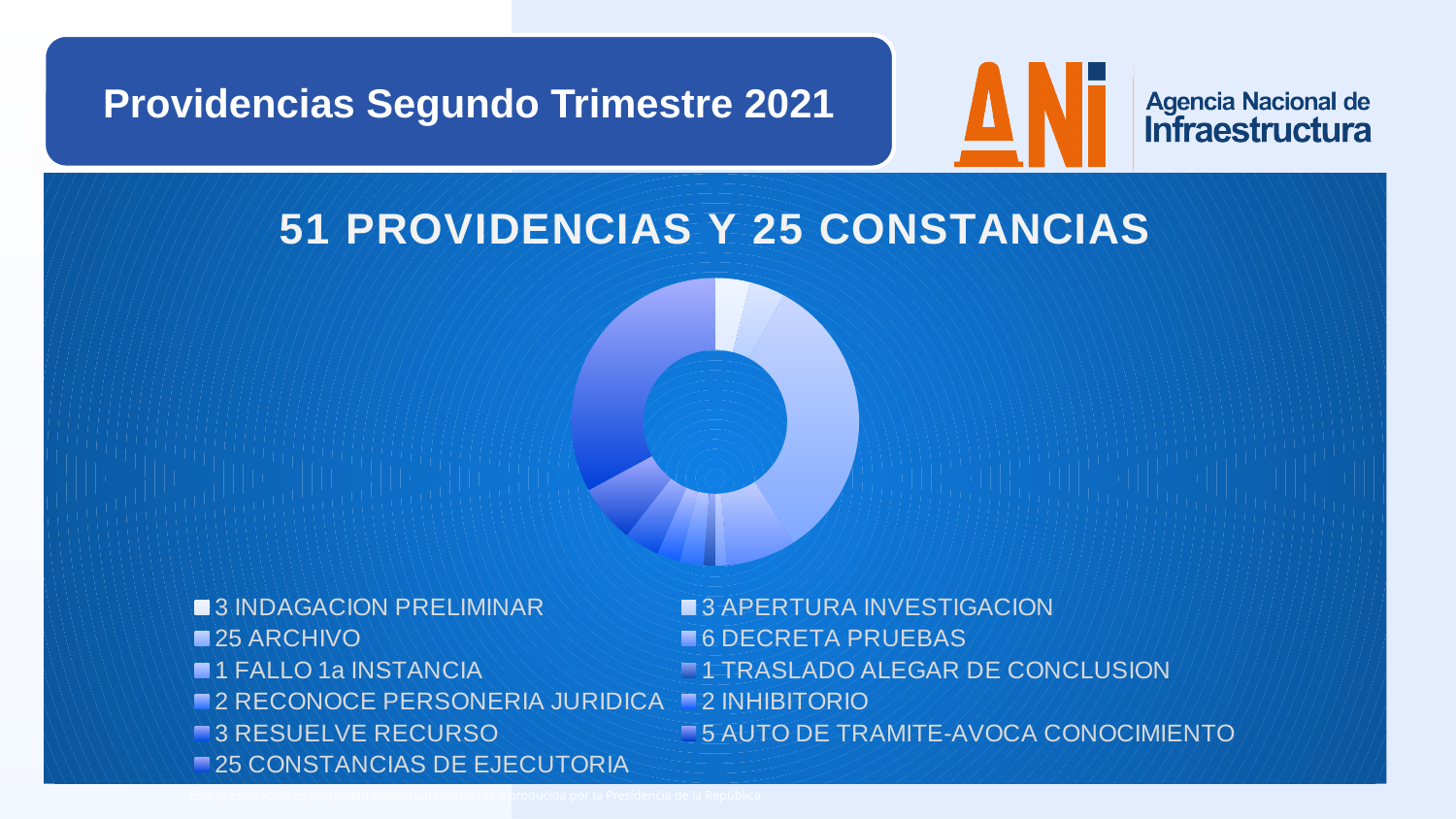
What is the difference between the values for DECRETA PRUEBAS and AUTO DE TRAMITE-AVOCA CONOCIMIENTO? 1 What heading appears directly above the chart? 51 PROVIDENCIAS Y 25 CONSTANCIAS What value does the legend give for CONSTANCIAS DE EJECUTORIA? 25 What value does the legend give for DECRETA PRUEBAS? 6 What value does the legend give for ARCHIVO? 25 What value does the legend give for RECONOCE PERSONERIA JURIDICA? 2 Which is larger, the value for INDAGACION PRELIMINAR or the value for INHIBITORIO? INDAGACION PRELIMINAR What kind of chart is shown on the slide? Doughnut chart What is the total of all the values listed in the chart's legend? 76 What is the difference between the values for ARCHIVO and DECRETA PRUEBAS? 19 How many categories does the chart's legend list? 11 What value does the legend give for AUTO DE TRAMITE-AVOCA CONOCIMIENTO? 5